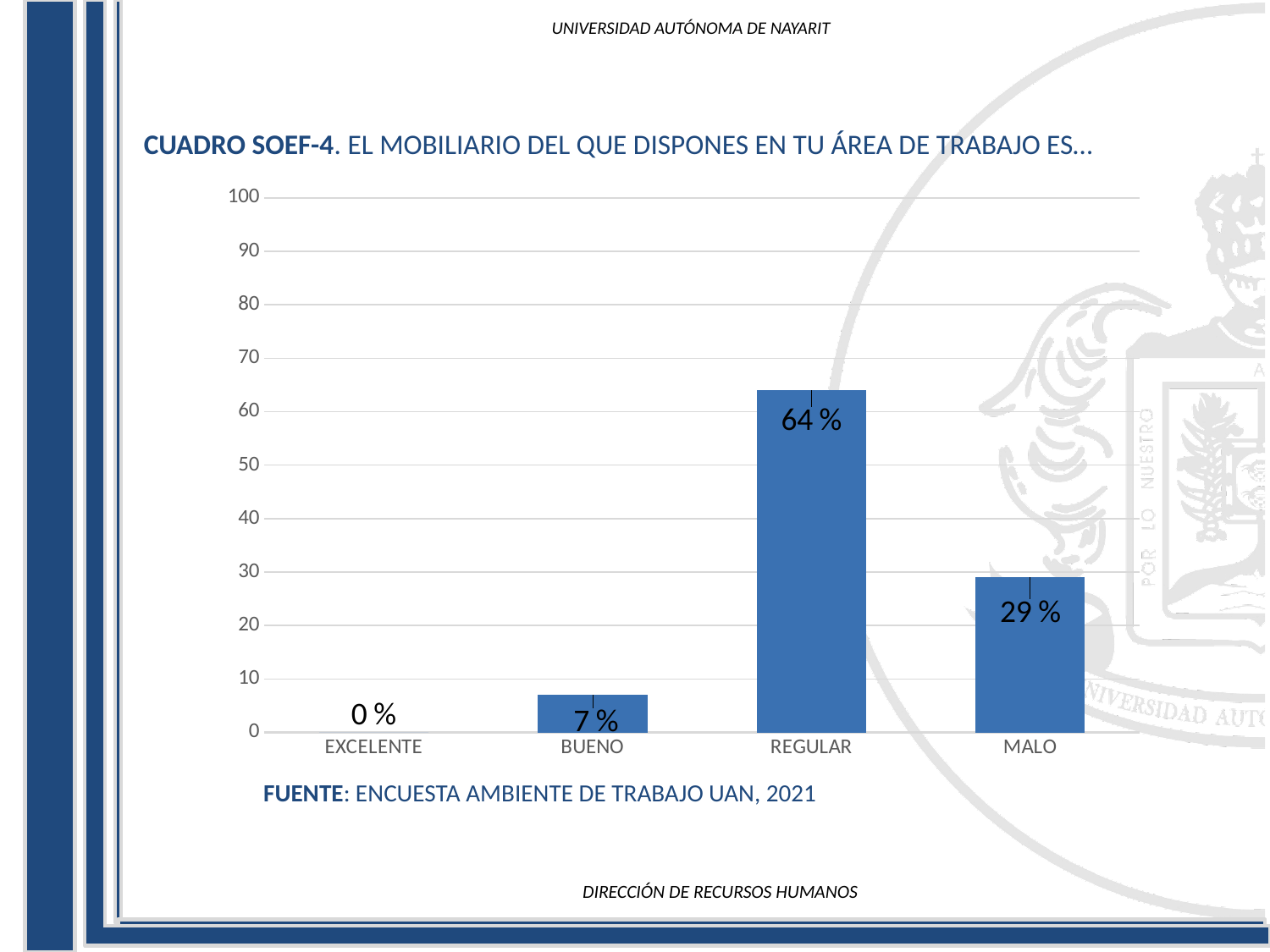
Which is larger, the value for BUENO or the value for MALO? MALO What is the difference between the values for REGULAR and MALO? 35 % What kind of chart is shown on the slide? bar chart What source is cited below the chart? ENCUESTA AMBIENTE DE TRABAJO UAN, 2021 What is the value for EXCELENTE? 0 % What is the value for REGULAR? 64 % Is the value for REGULAR greater or less than 50? greater What is the value for BUENO? 7 % Which category has the lowest value? EXCELENTE How many categories are shown on the x axis? 4 Which category has the highest value? REGULAR What is the value for MALO? 29 %